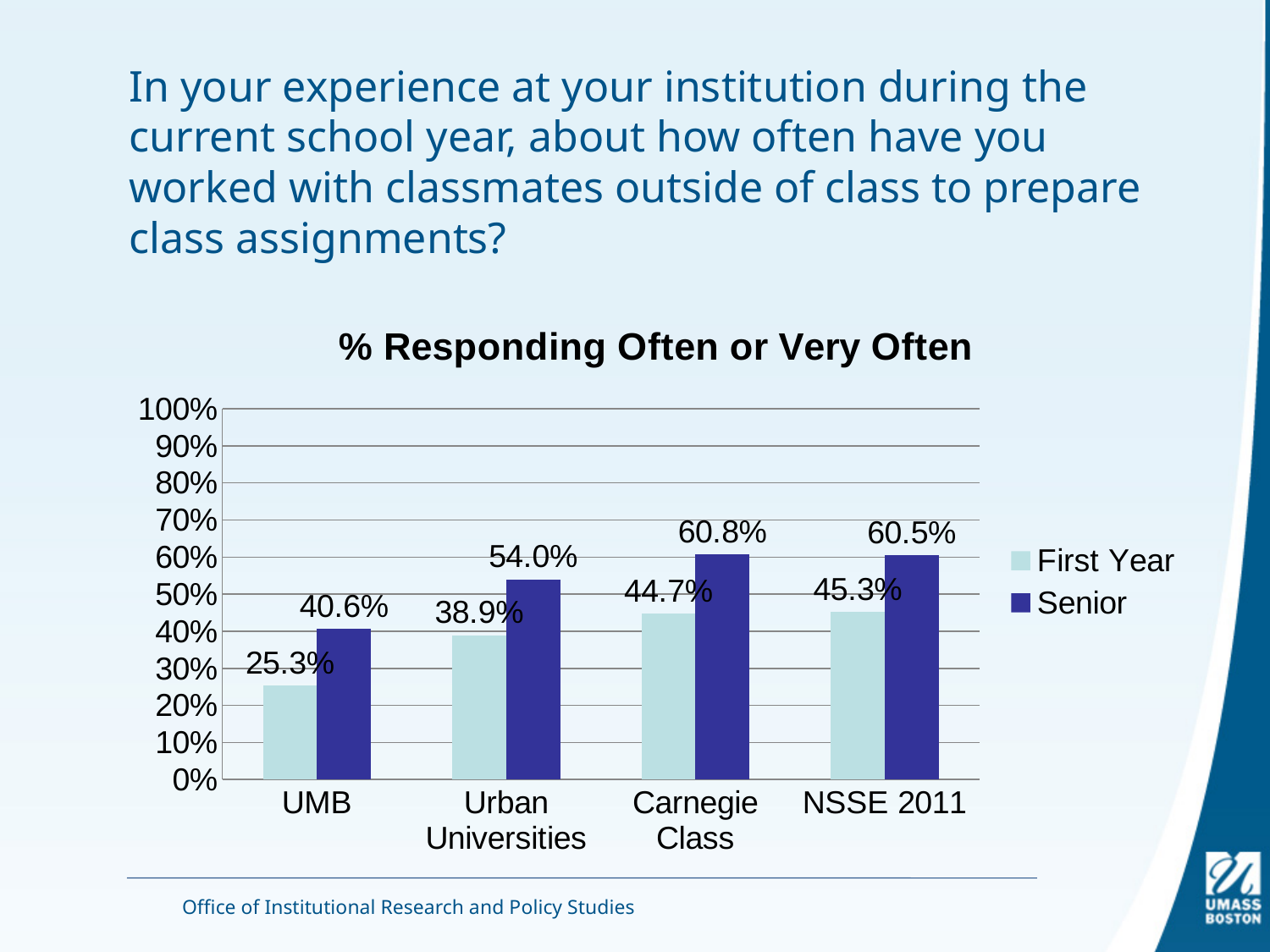
Which category has the highest Senior value? Carnegie Class What kind of chart is shown on the slide? Bar chart What is the title of the chart? % Responding Often or Very Often What is the First Year value for NSSE 2011? 45.3% What is the First Year value for UMB? 25.3% What is the difference between the Senior and First Year values for UMB? 15.3 percentage points What is the Senior value for Carnegie Class? 60.8% Which category has the lowest First Year value? UMB Which is larger, the Senior value for UMB or the First Year value for Carnegie Class? First Year value for Carnegie Class How many categories are shown on the x axis? 4 What is the Senior value for Urban Universities? 54.0% How many series does the legend list? 2